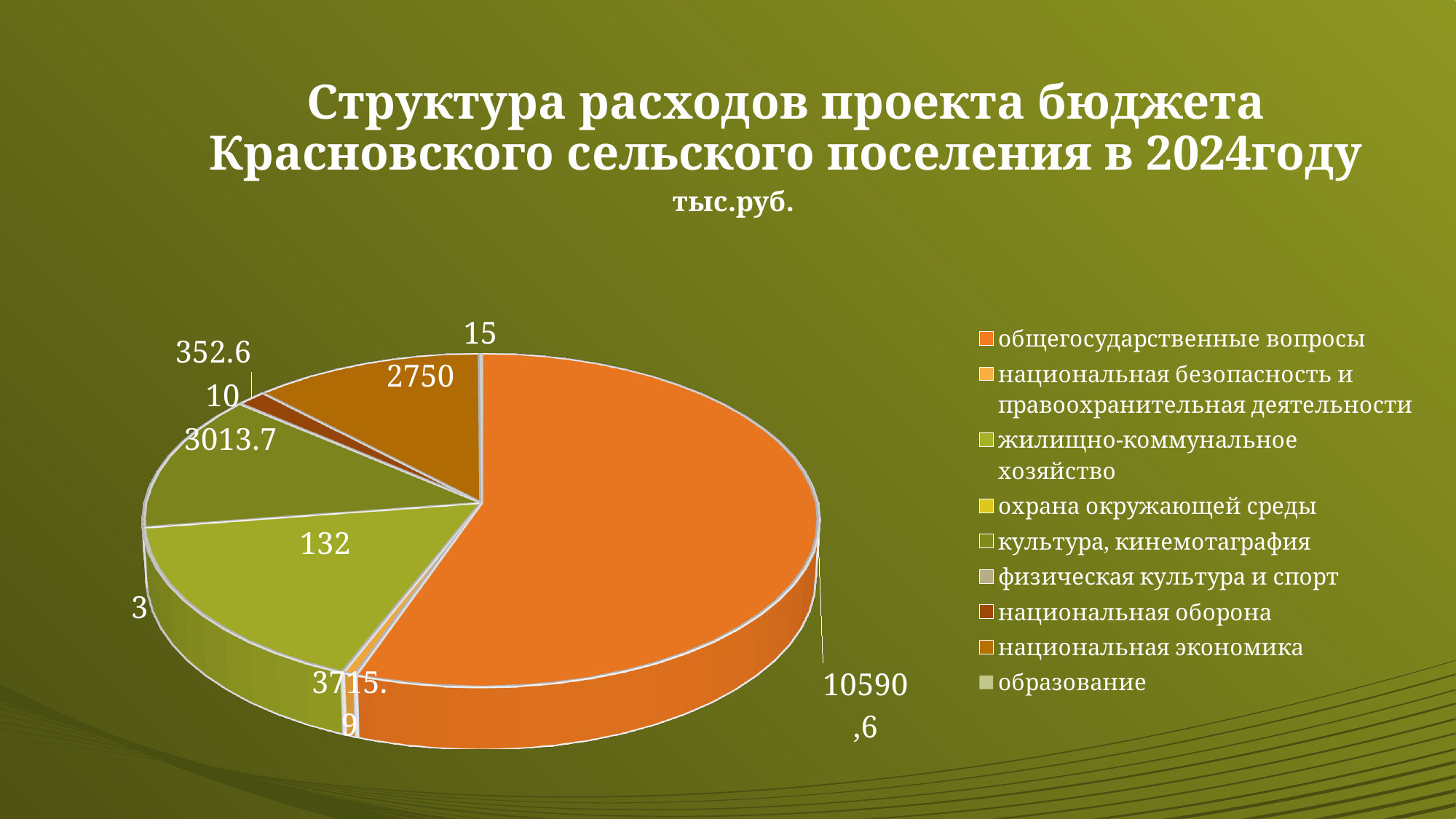
What kind of chart is shown on the slide? pie chart How many categories does the legend of the pie chart list? 9 What is the value shown for общегосударственные вопросы? 10590,6 What is the value shown for культура, кинемотаграфия? 3013.7 What colour is the slice for общегосударственные вопросы? orange What is the value shown for национальная экономика? 2750 Which is larger: общегосударственные вопросы or национальная экономика? общегосударственные вопросы Which category has the largest slice in the pie chart? общегосударственные вопросы What is the difference between the values for культура, кинемотаграфия and национальная экономика? 263.7 Which is larger: национальная экономика or культура, кинемотаграфия? культура, кинемотаграфия In what units are the values in the chart given, according to the subtitle? тыс.руб.